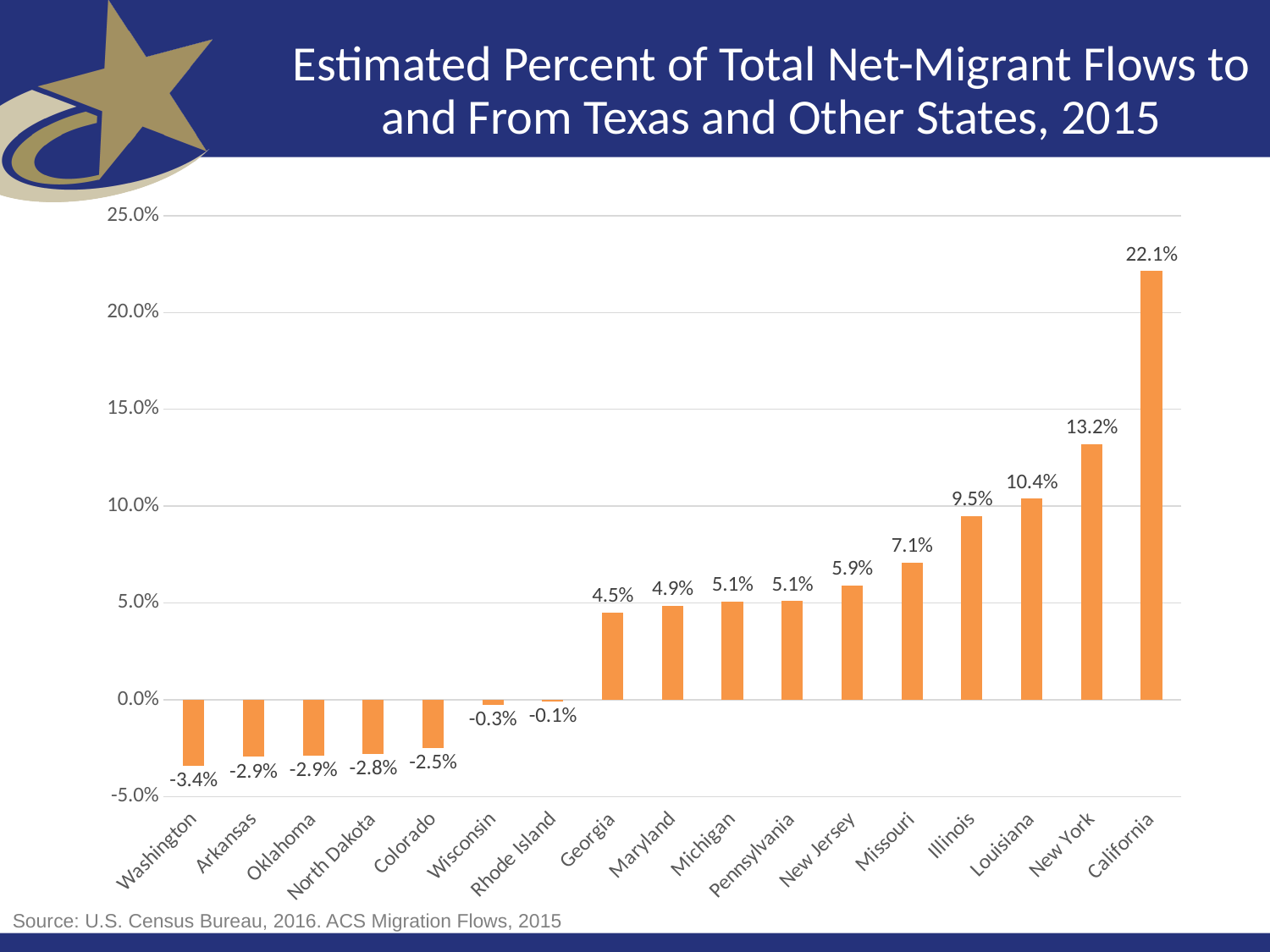
What is the difference between the values for Louisiana and Illinois? 0.9% What is the difference between the values for California and New York? 8.9% What is the value for California? 22.1% Which state has the lowest value? Washington How many states are shown on the chart? 17 Which is larger, the value for New Jersey or the value for Georgia? New Jersey What is the value for Washington? -3.4% Do the values rise or fall from left to right along the x axis? rise What kind of chart is shown on the slide? bar chart Which state has the highest value? California What is the value for Missouri? 7.1% Is the value for New York greater or less than 15.0%? less